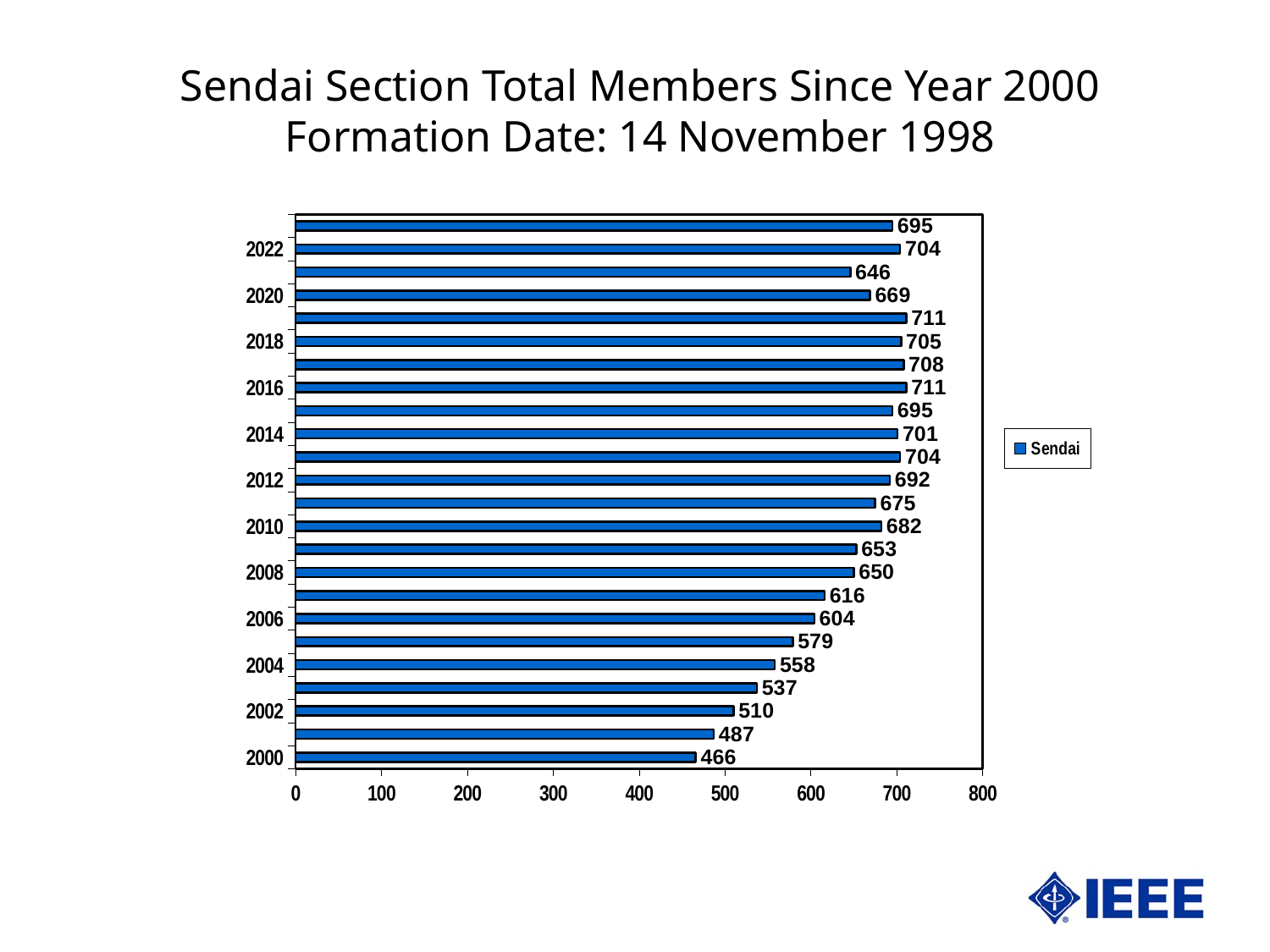
What is the highest value shown on the chart? 711 What is the value for 2022? 704 What is the value for 2000? 466 Is the value for 2006 greater or less than 500? greater How many bars are plotted on the chart? 24 What is the difference between the values for 2022 and 2000? 238 What kind of chart is shown? bar chart What series name does the legend show? Sendai Which year has the lowest value? 2000 Which is larger, the value for 2018 or the value for 2020? 2018 What is the value for 2010? 682 What is the value for 2020? 669